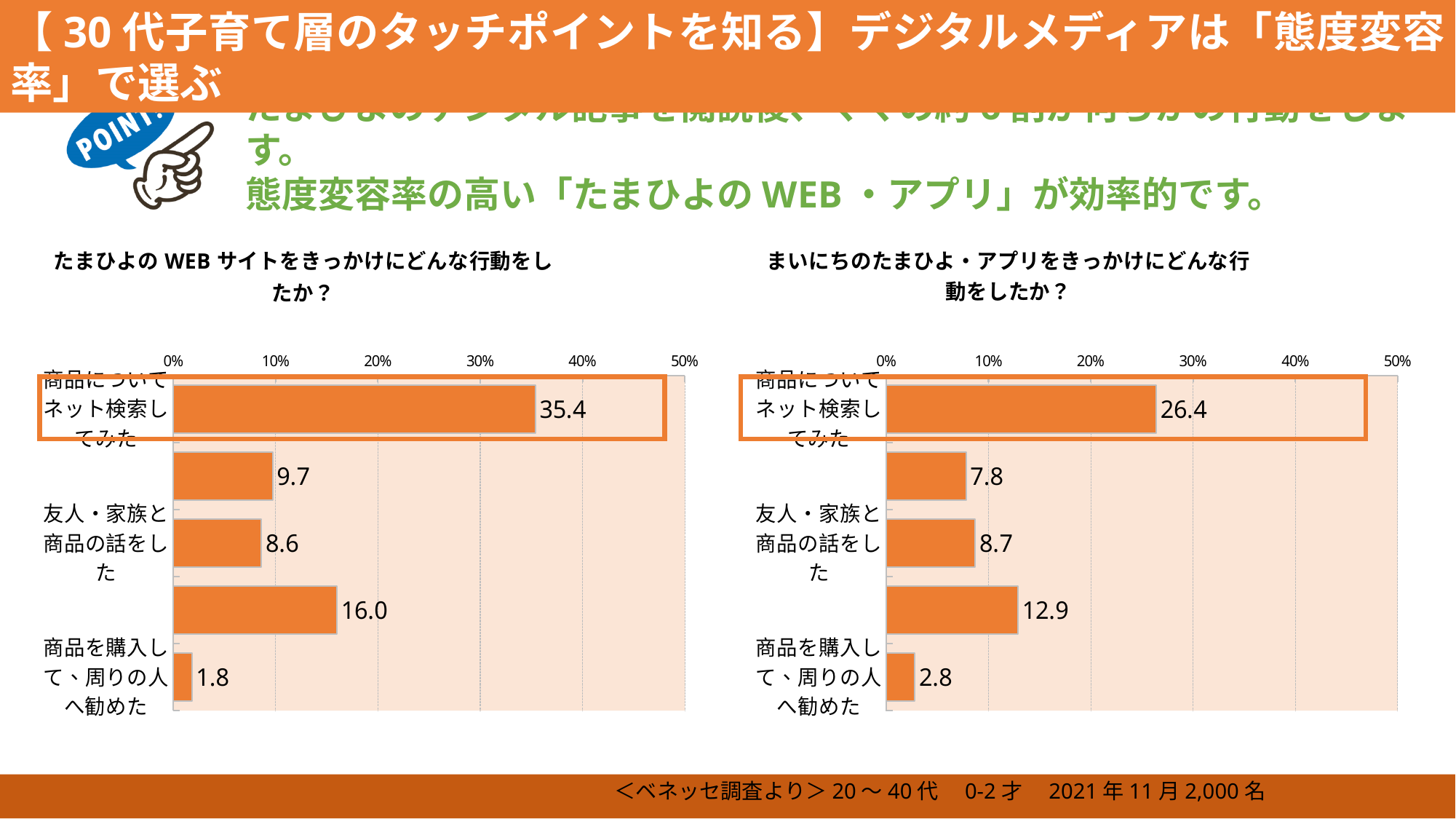
In the right chart (まいにちのたまひよ・アプリ), what is the value for 商品を購入して、周りの人へ勧めた? 2.8 In the right chart (まいにちのたまひよ・アプリ), which category has the lowest value? 商品を購入して、周りの人へ勧めた What is the difference between the value for 商品についてネット検索してみた in the left chart and in the right chart? 9.0 In the left chart (たまひよのWEBサイト), is the value for 商品についてネット検索してみた greater or less than 30%? greater In the right chart (まいにちのたまひよ・アプリをきっかけにどんな行動をしたか？), what is the value for 商品についてネット検索してみた? 26.4 In the left chart (たまひよのWEBサイト), which category has the highest value? 商品についてネット検索してみた What kind of chart is used on this slide? bar chart In the left chart (たまひよのWEBサイト), what is the value for 友人・家族と商品の話をした? 8.6 In the left chart (たまひよのWEBサイトをきっかけにどんな行動をしたか？), what is the value for 商品についてネット検索してみた? 35.4 In the right chart (まいにちのたまひよ・アプリ), what is the difference between 商品についてネット検索してみた and 商品を購入して、周りの人へ勧めた? 23.6 Which chart has the larger value for 友人・家族と商品の話をした, the left (WEBサイト) or the right (アプリ)? the right chart (アプリ) How many bars are plotted in the left chart (たまひよのWEBサイト)? 5